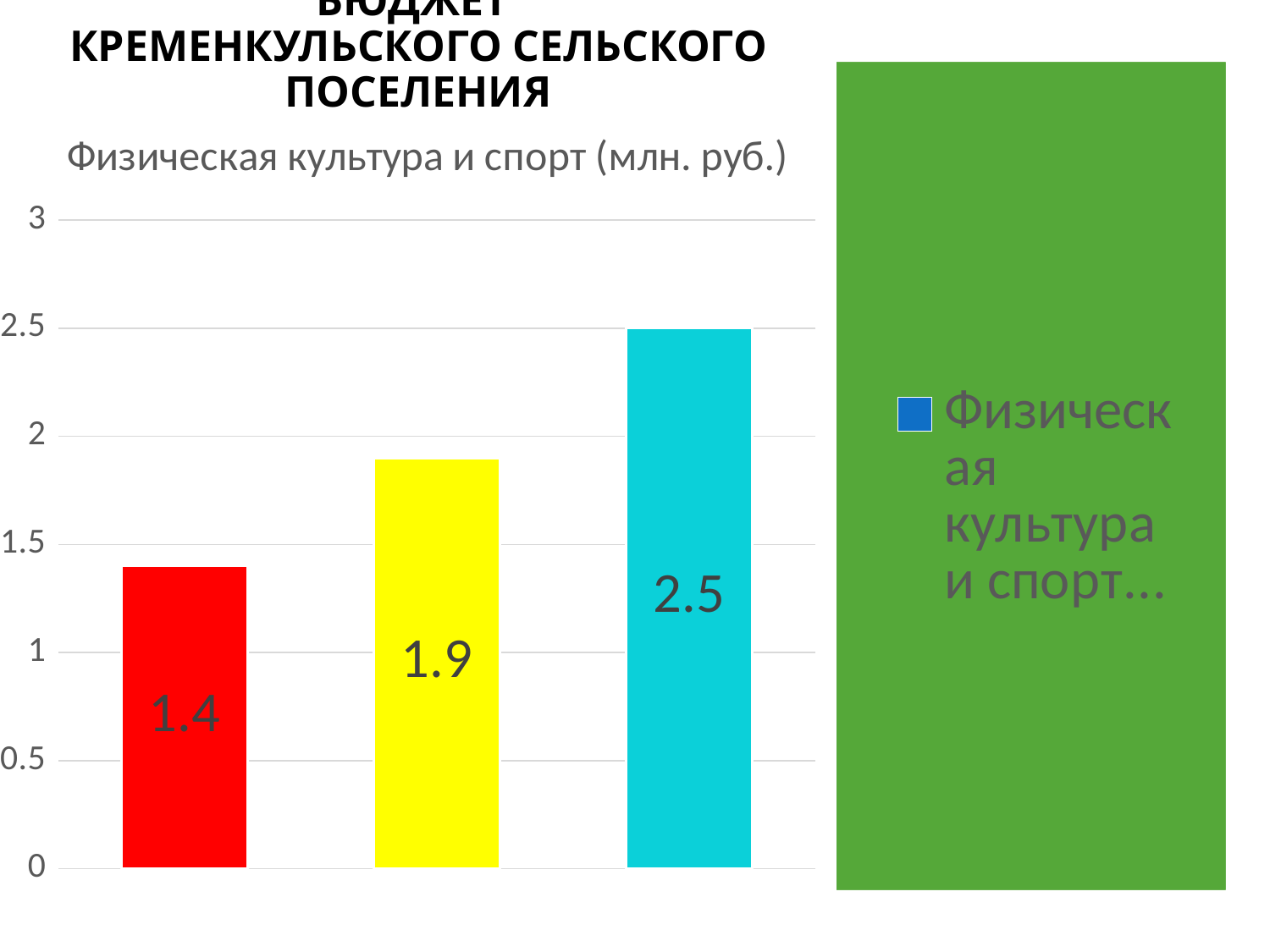
Which bar has the highest value in the chart? The rightmost (cyan) bar, 2.5 Is the value of the yellow bar greater or less than 2? less What is the difference between the yellow bar and the red bar? 0.5 What is the value of the red bar in the chart? 1.4 Which bar has the lowest value in the chart? The leftmost (red) bar, 1.4 How many bars are plotted in the chart? 3 Do the bar values rise or fall from left to right? Rise Which is larger, the yellow bar or the cyan bar? The cyan bar What is the difference between the cyan bar and the red bar? 1.1 What is the value of the rightmost (cyan) bar in the chart? 2.5 What is the value of the yellow bar in the chart? 1.9 What type of chart is shown on the slide? Bar chart